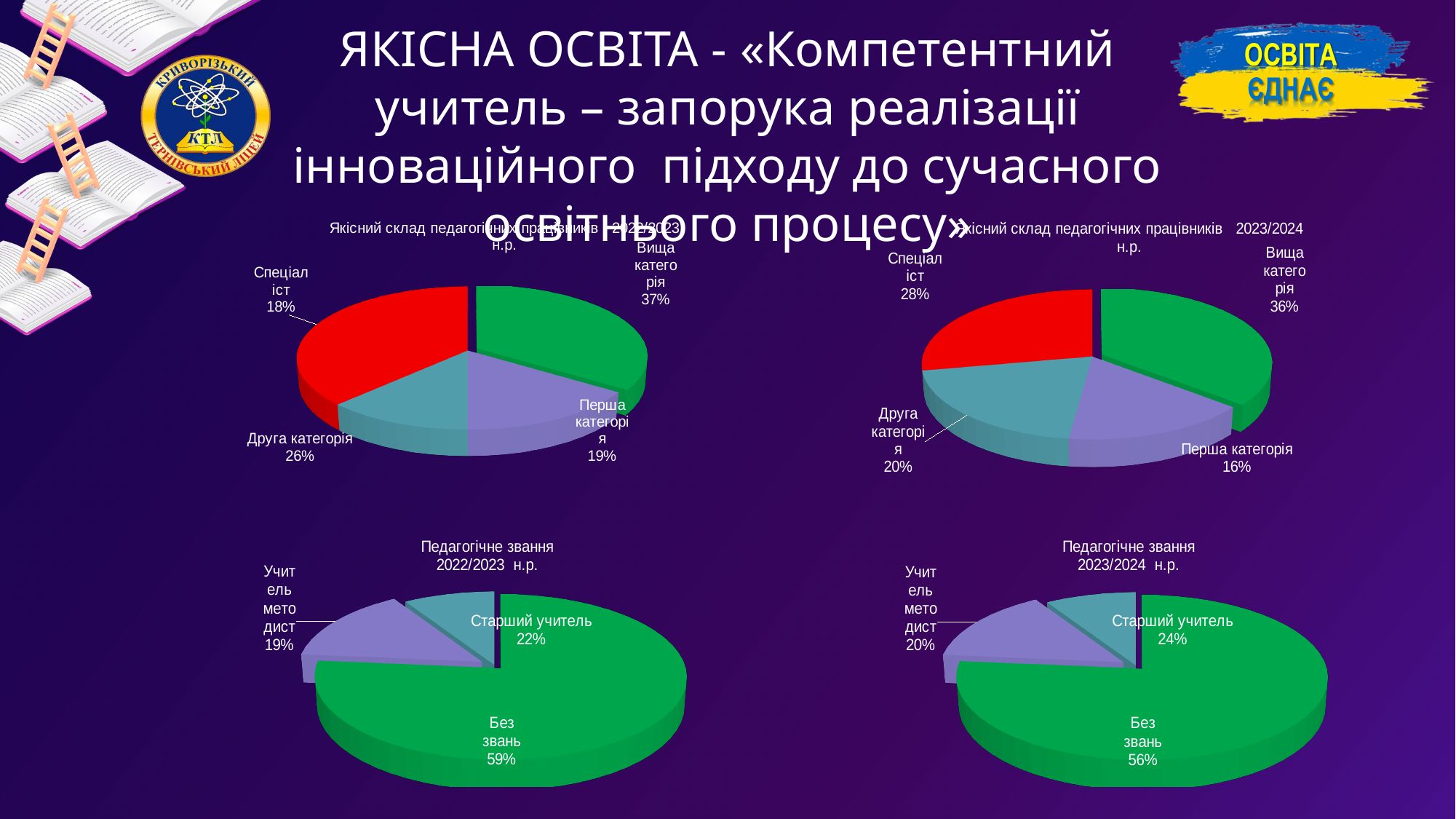
In the top-right pie chart (Якісний склад педагогічних працівників 2023/2024 н.р.), what share is labelled for Спеціаліст? 28% In the bottom-left pie chart (Педагогічне звання 2022/2023 н.р.), what share is labelled for Без звань? 59% In the top-right pie chart (2023/2024), which category has the largest share? Вища категорія In the bottom-right pie chart (Педагогічне звання 2023/2024 н.р.), what share is labelled for Старший учитель? 24% How many slices does the top-left pie chart (2022/2023) have? 4 How many slices does the bottom-right pie chart (Педагогічне звання 2023/2024 н.р.) have? 3 What type of chart is used for Педагогічне звання 2022/2023 н.р. at the bottom left of the slide? Pie chart In the top-left pie chart (Якісний склад педагогічних працівників 2022/2023 н.р.), what share is labelled for Вища категорія? 37% In the top-right pie chart (2023/2024), what is the difference between the shares for Друга категорія and Перша категорія? 4% In the top-left pie chart (2022/2023), what share is labelled for Друга категорія? 26%